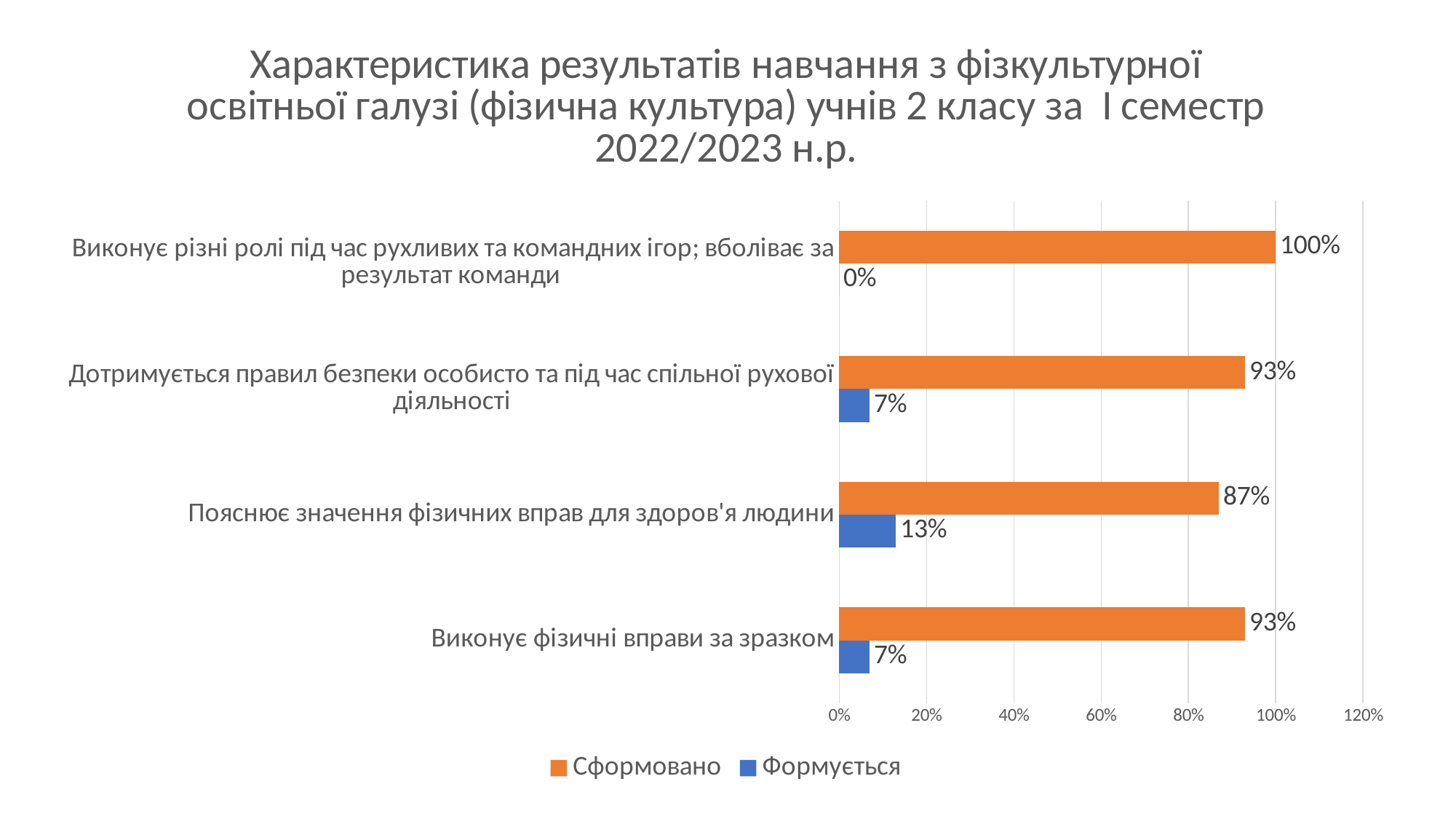
Which category has the highest "Сформовано" value? Виконує різні ролі під час рухливих та командних ігор; вболіває за результат команди What is the value of "Формується" for "Пояснює значення фізичних вправ для здоров'я людини"? 13% What type of chart is shown on the slide? Bar chart What is the difference between the "Сформовано" and "Формується" values for "Пояснює значення фізичних вправ для здоров'я людини"? 74% How many categories are shown on the chart? 4 What is the value of "Сформовано" for "Дотримується правил безпеки особисто та під час спільної рухової діяльності"? 93% How many series does the legend list? 2 Which category has the lowest "Сформовано" value? Пояснює значення фізичних вправ для здоров'я людини Which is larger: the "Сформовано" value for "Виконує фізичні вправи за зразком" or for "Пояснює значення фізичних вправ для здоров'я людини"? Виконує фізичні вправи за зразком What is the value of "Сформовано" for "Виконує фізичні вправи за зразком"? 93% Which category has the highest "Формується" value? Пояснює значення фізичних вправ для здоров'я людини What is the value of "Формується" for "Виконує різні ролі під час рухливих та командних ігор; вболіває за результат команди"? 0%